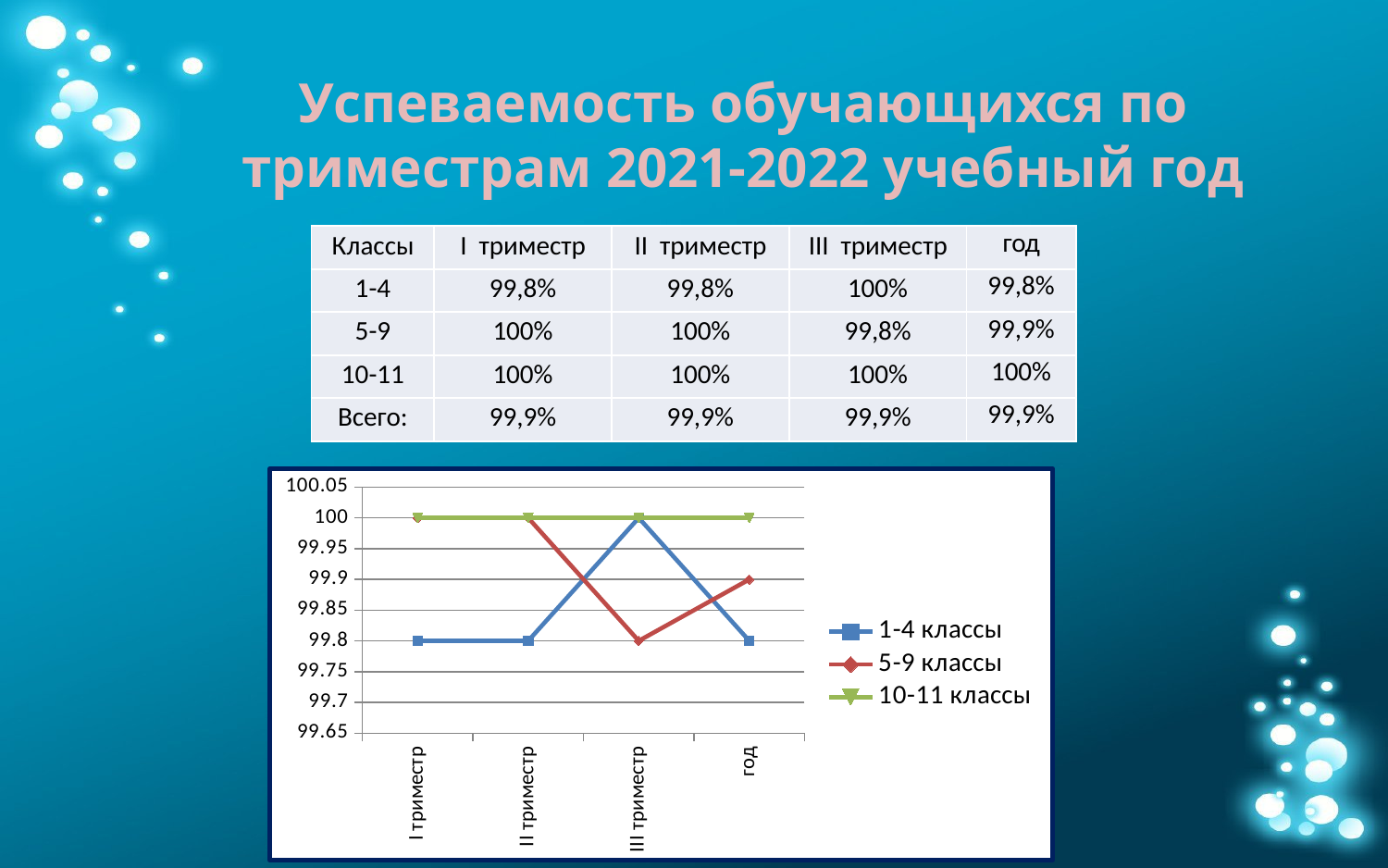
In the chart, what is the value for 5-9 классы in III триместр? 99.8 In the chart, what is the value for 5-9 классы for год? 99.9 Which series in the chart is drawn with a green line? 10-11 классы What kind of chart is shown on the slide? line chart In the chart, which series has the lowest value in III триместр? 5-9 классы In the chart, what is the value for 1-4 классы in III триместр? 100 In the chart, does the 5-9 классы line rise or fall from II триместр to III триместр? fall How many series does the chart legend list? 3 How many points are plotted along the x axis for each series in the chart? 4 In the chart, what is the value for 1-4 классы in I триместр? 99.8 In the chart, what is the difference between the 10-11 классы value and the 1-4 классы value in I триместр? 0.2 In the chart, which series is higher in II триместр: 1-4 классы or 5-9 классы? 5-9 классы